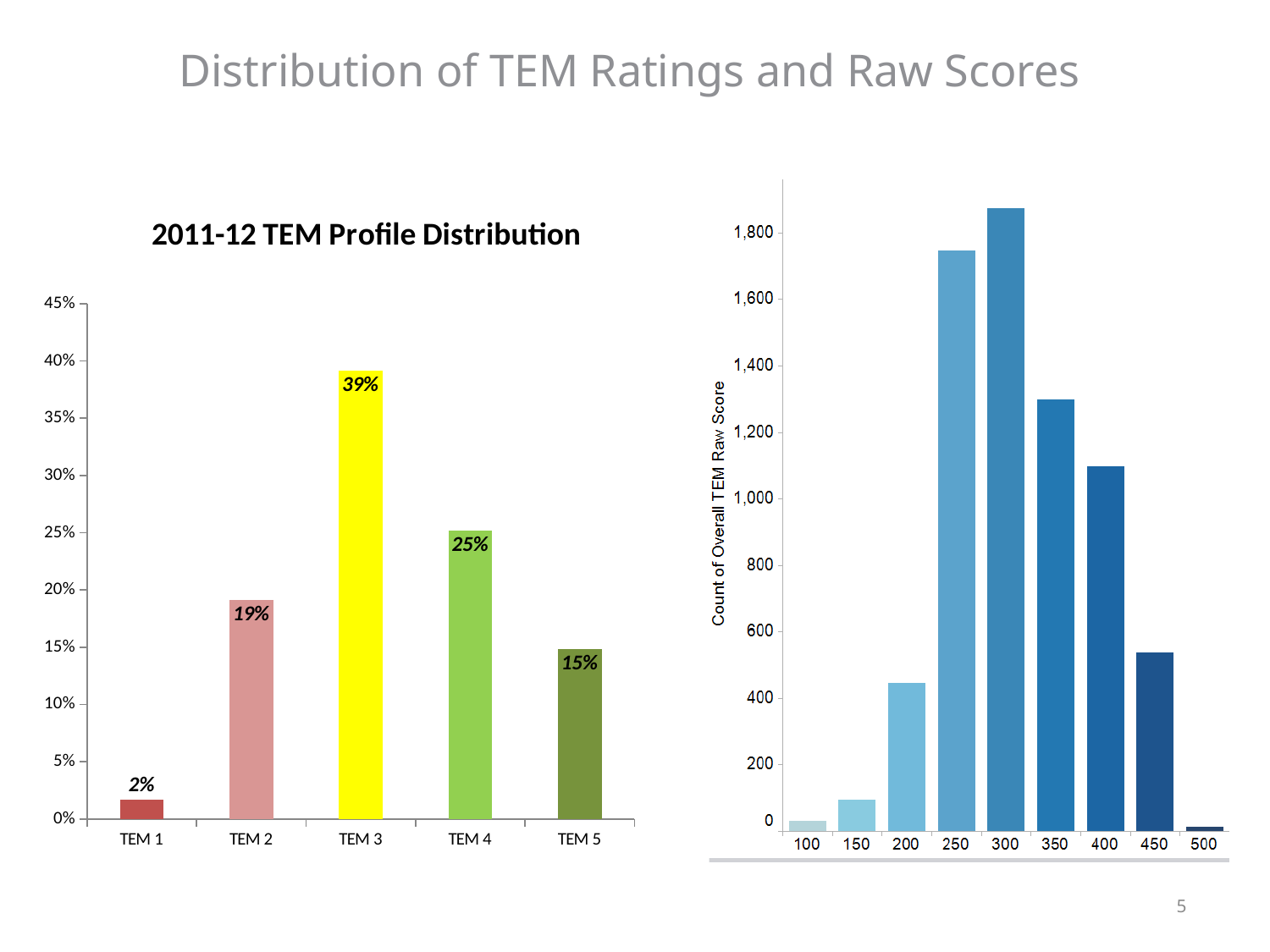
In the 2011-12 TEM Profile Distribution chart, what percentage is shown for TEM 3? 39% In the 2011-12 TEM Profile Distribution chart, what is the difference between the percentages for TEM 4 and TEM 5? 10% In the chart on the right (Count of Overall TEM Raw Score), which raw score bin has the highest count? 300 In the chart on the right (Count of Overall TEM Raw Score), is the count for the 450 bin greater or less than 800? less In the chart on the right (Count of Overall TEM Raw Score), is the count for the 250 bin greater or less than 1,600? greater In the 2011-12 TEM Profile Distribution chart, which TEM category has the lowest percentage? TEM 1 How many TEM categories are shown in the 2011-12 TEM Profile Distribution chart? 5 In the 2011-12 TEM Profile Distribution chart, what percentage is shown for TEM 1? 2% In the 2011-12 TEM Profile Distribution chart, which TEM category has the highest percentage? TEM 3 What type of chart is the 2011-12 TEM Profile Distribution chart? Bar chart How many raw score bins are shown on the x axis of the chart on the right (Count of Overall TEM Raw Score)? 9 In the 2011-12 TEM Profile Distribution chart, which is larger, the percentage for TEM 2 or for TEM 4? TEM 4